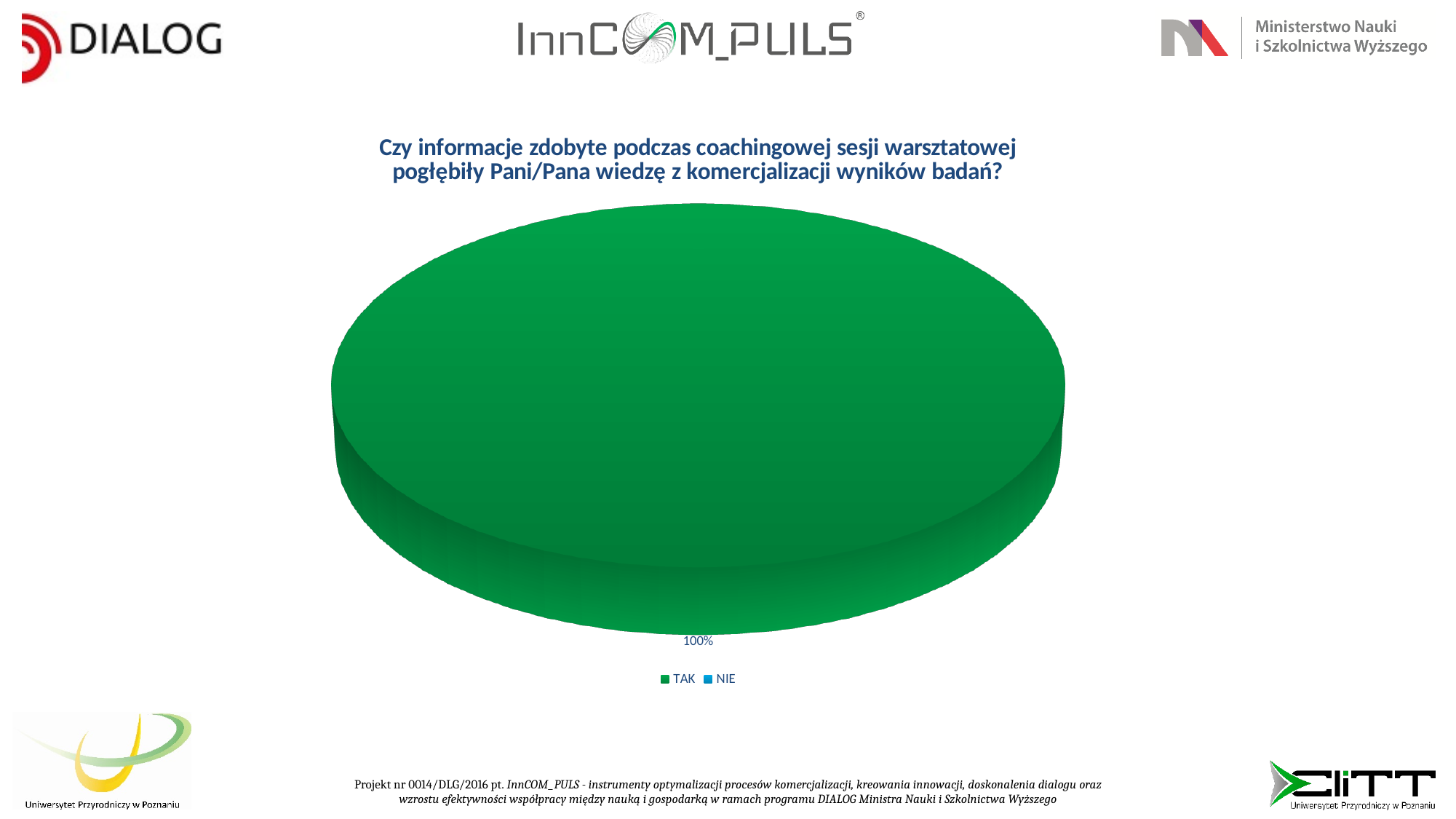
What is the only data label printed on the pie chart? 100% What are the two entries listed in the chart legend? TAK and NIE What kind of chart is shown on the slide? pie chart Which category has the smallest share of the pie? NIE What share of the pie does the NIE category hold, given that TAK holds 100%? 0% How many categories does the legend list? 2 Which of the two categories, TAK or NIE, has the larger share? TAK What colour represents the TAK category in the legend? green Which category has the largest share of the pie? TAK What share of the pie does the TAK category hold? 100%